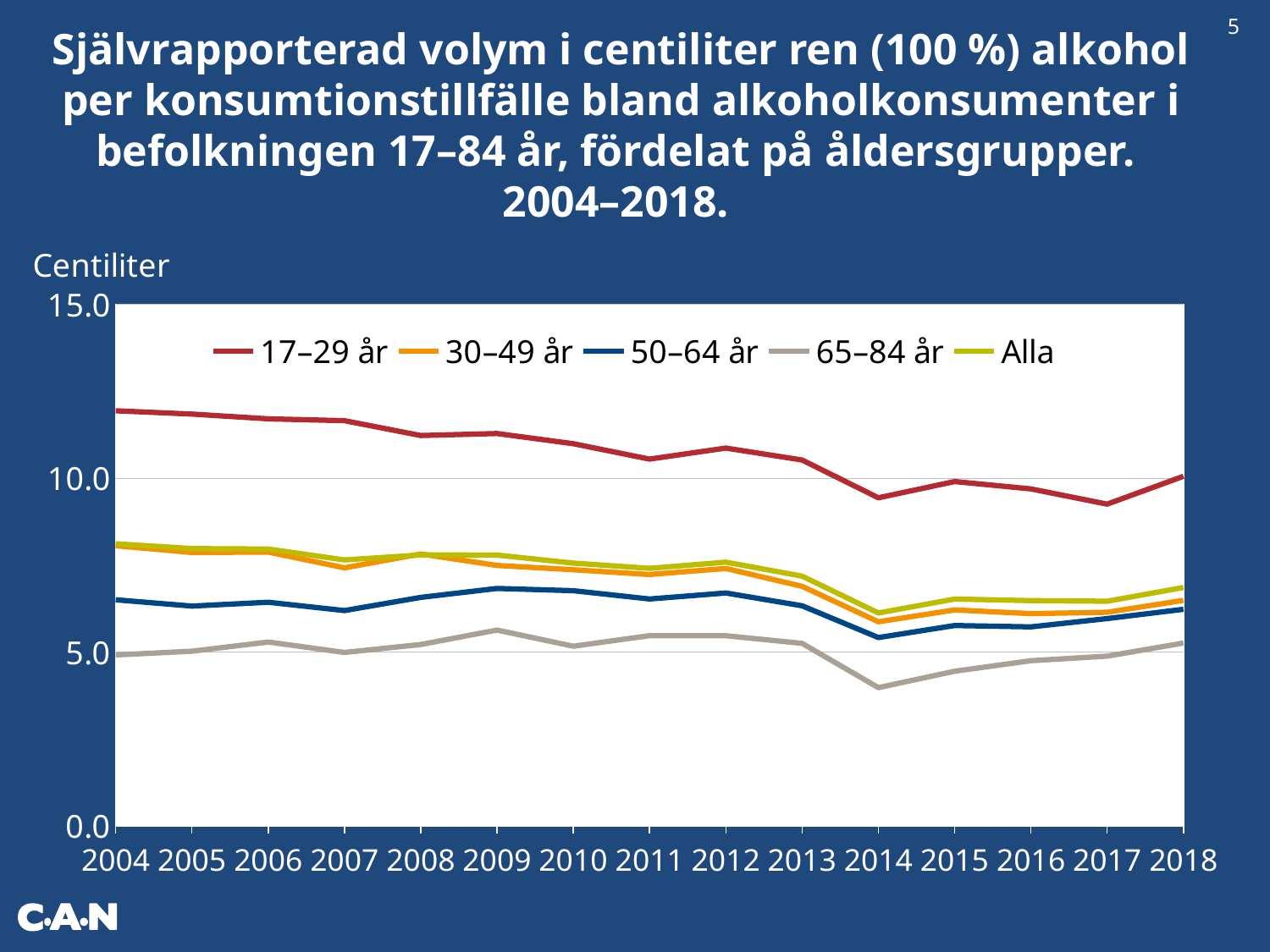
What kind of chart is shown on the slide? line chart Which age group has the highest values across all years? 17–29 år Is the value for 17–29 år in 2004 greater or less than 10.0? greater In 2010, which is larger: the value for 17–29 år or the value for 65–84 år? 17–29 år How many years are shown along the x axis? 15 Is the value for 65–84 år in 2014 greater or less than 5.0? less Does the line for 17–29 år generally rise or fall from 2004 to 2018? fall Which age group has the lowest values across all years? 65–84 år Is the value for 17–29 år in 2014 greater or less than 10.0? less How many series does the legend list? 5 What is the label shown above the y axis? Centiliter